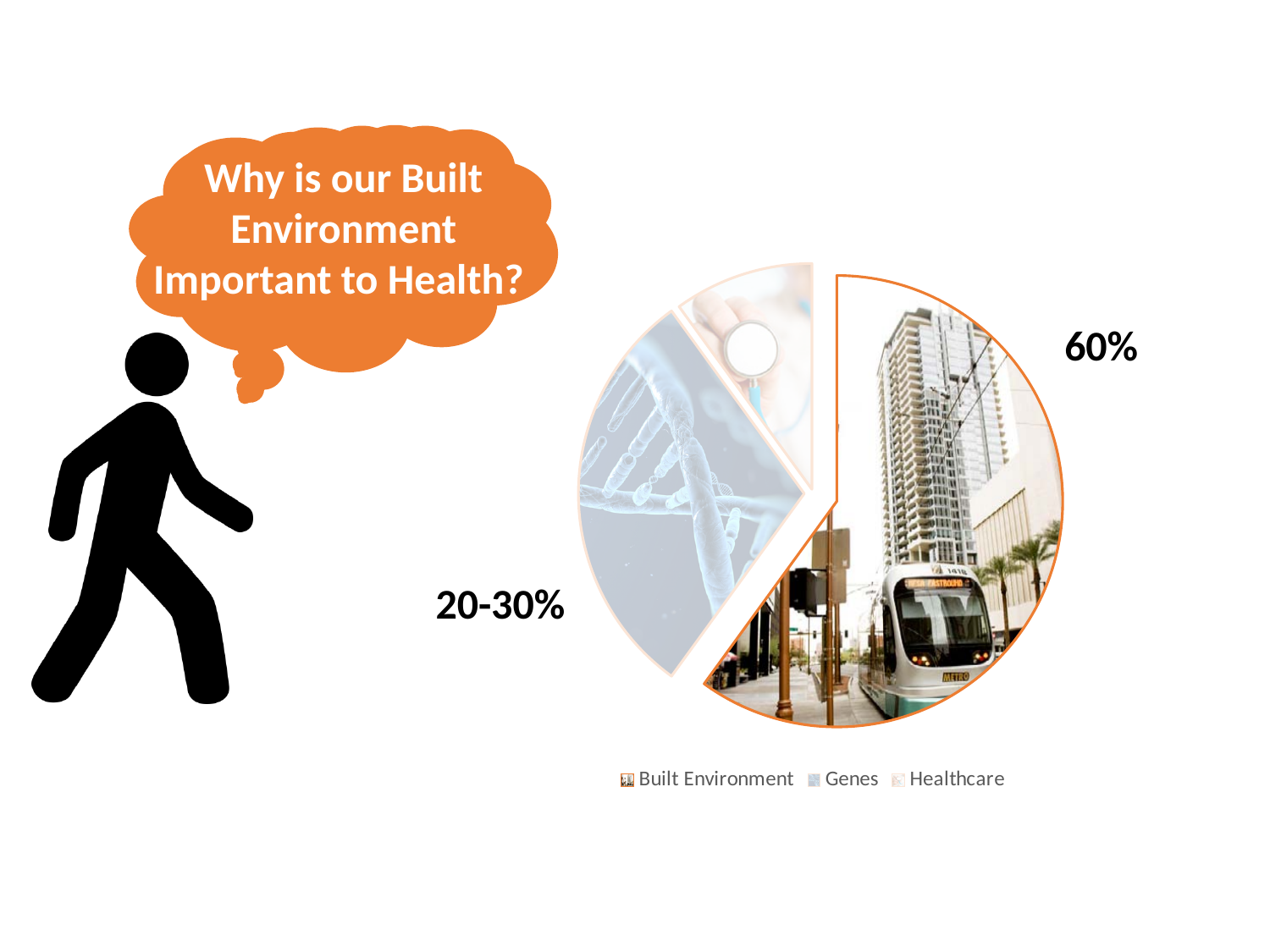
What kind of chart is shown on the slide? pie chart Which category has the smallest slice of the pie chart? Healthcare Which slice is larger in the pie chart, Built Environment or Genes? Built Environment What are the three categories listed in the pie chart's legend? Built Environment, Genes, Healthcare Which category has the largest slice of the pie chart? Built Environment What percentage is labelled on the Built Environment slice of the pie chart? 60% What value is labelled on the Genes slice of the pie chart? 20-30% Which slice is larger in the pie chart, Genes or Healthcare? Genes Which slice of the pie chart is pulled out (exploded) from the rest? Built Environment What share of the pie does the Built Environment slice represent? 60% How many entries does the pie chart's legend list? 3 How many slices does the pie chart have? 3